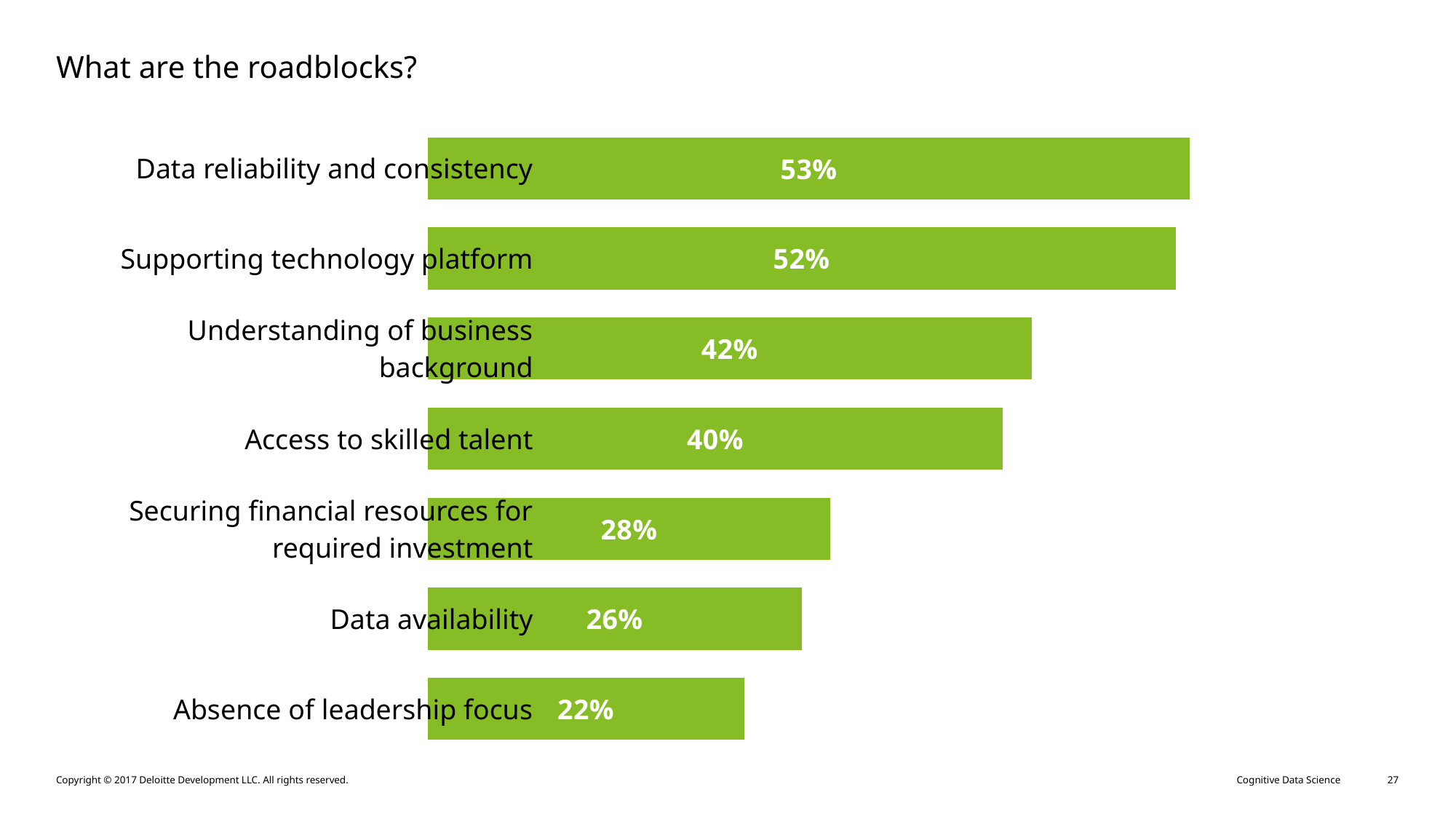
Which roadblock has the highest percentage? Data reliability and consistency Which is larger, the value for Securing financial resources for required investment or the value for Data availability? Securing financial resources for required investment What is the value for Absence of leadership focus? 22% How many roadblock categories are shown in the chart? 7 What percentage is shown for Securing financial resources for required investment? 28% What kind of chart is shown on the slide? Bar chart What is the value for Access to skilled talent? 40% What percentage is shown for Data reliability and consistency? 53% Which roadblock has the lowest percentage? Absence of leadership focus What is the difference between the values for Supporting technology platform and Data availability? 26% What is the title of the slide? What are the roadblocks? What is the difference between Understanding of business background and Access to skilled talent? 2%